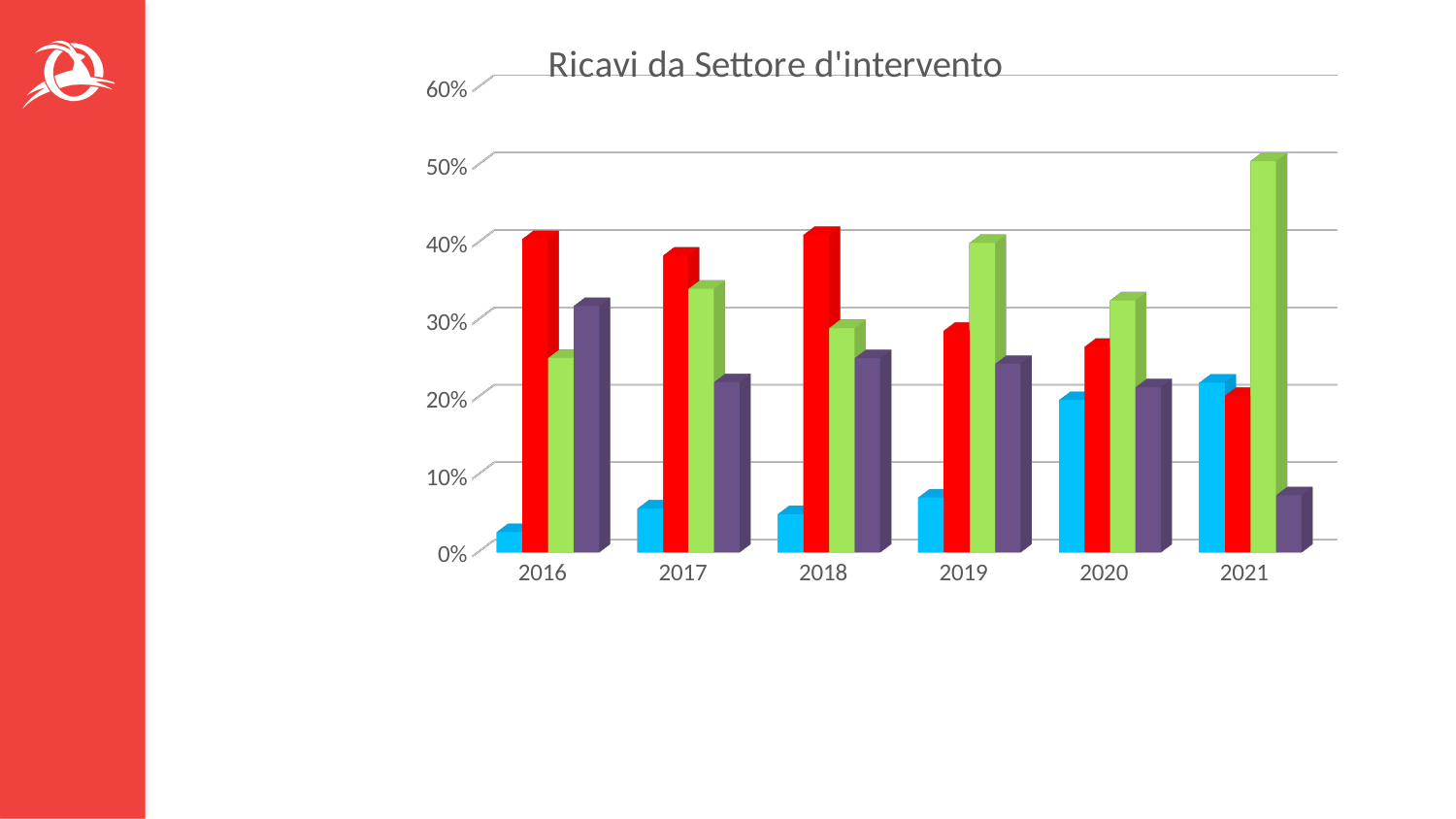
Is the value of the green bar for 2021 greater or less than 40%? greater Is the value of the light-blue bar for 2016 greater or less than 10%? less Is the value of the purple bar for 2021 greater or less than 10%? less How many bars are plotted for each year in the chart? 4 How many years are shown on the x axis of the chart? 6 What kind of chart is shown on the slide? bar chart In which year does the chart show its tallest bar overall? 2021 Do the light-blue bars rise or fall from 2018 to 2021? rise What is the title of the chart? Ricavi da Settore d'intervento Do the red bars rise or fall from 2018 to 2021? fall